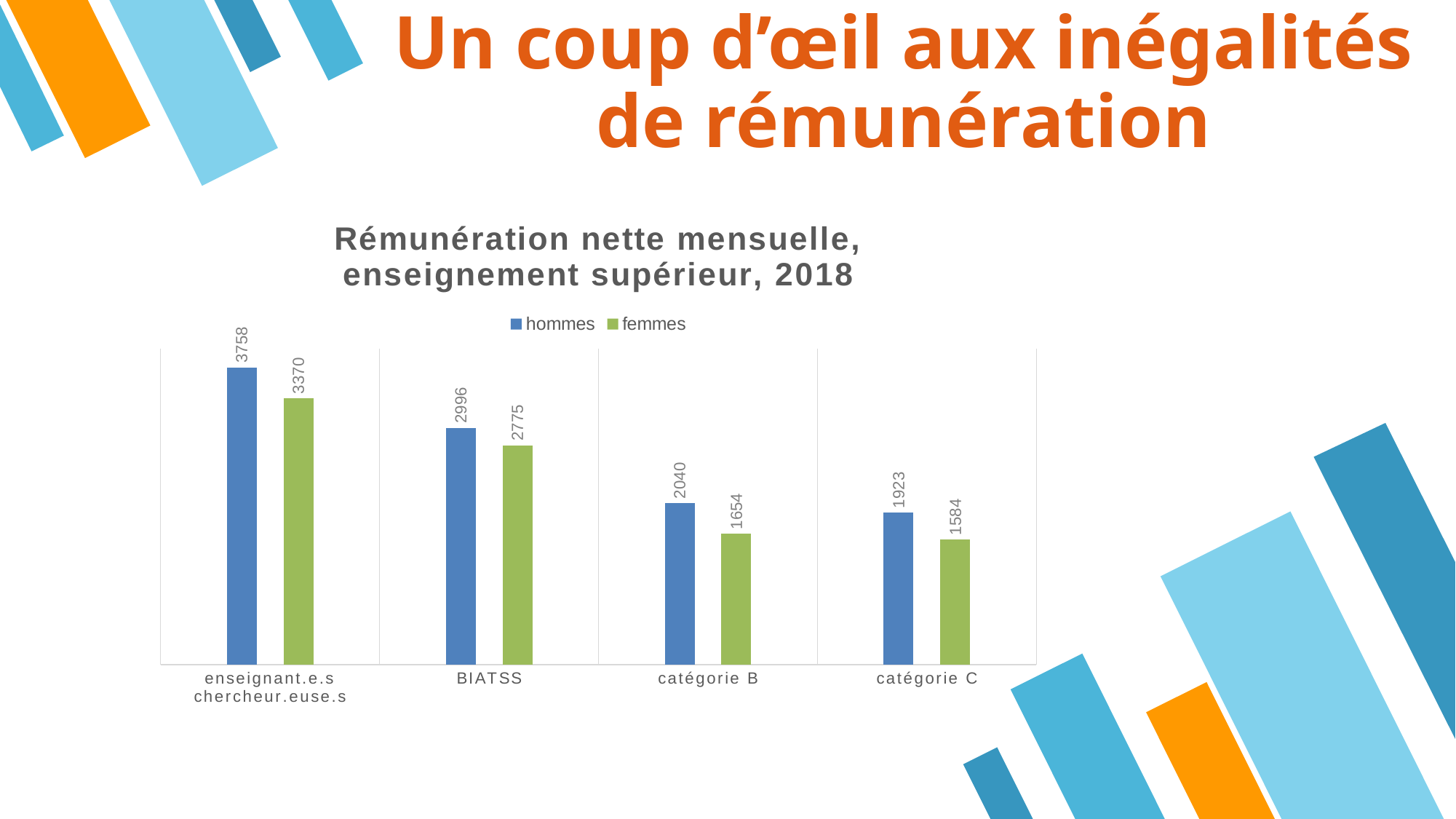
What kind of chart is shown on the slide? bar chart What is the value for femmes in the BIATSS category? 2775 What is the value for femmes in catégorie C? 1584 What is the value for hommes in the enseignant.e.s chercheur.euse.s category? 3758 Which category has the lowest value for femmes? catégorie C How many series does the legend list? 2 What is the title of the chart? Rémunération nette mensuelle, enseignement supérieur, 2018 How many categories are shown on the x axis? 4 Which is larger in BIATSS, the value for hommes or for femmes? hommes What is the difference between hommes and femmes in catégorie B? 386 What is the difference between hommes and femmes in the enseignant.e.s chercheur.euse.s category? 388 Which category has the highest value for hommes? enseignant.e.s chercheur.euse.s